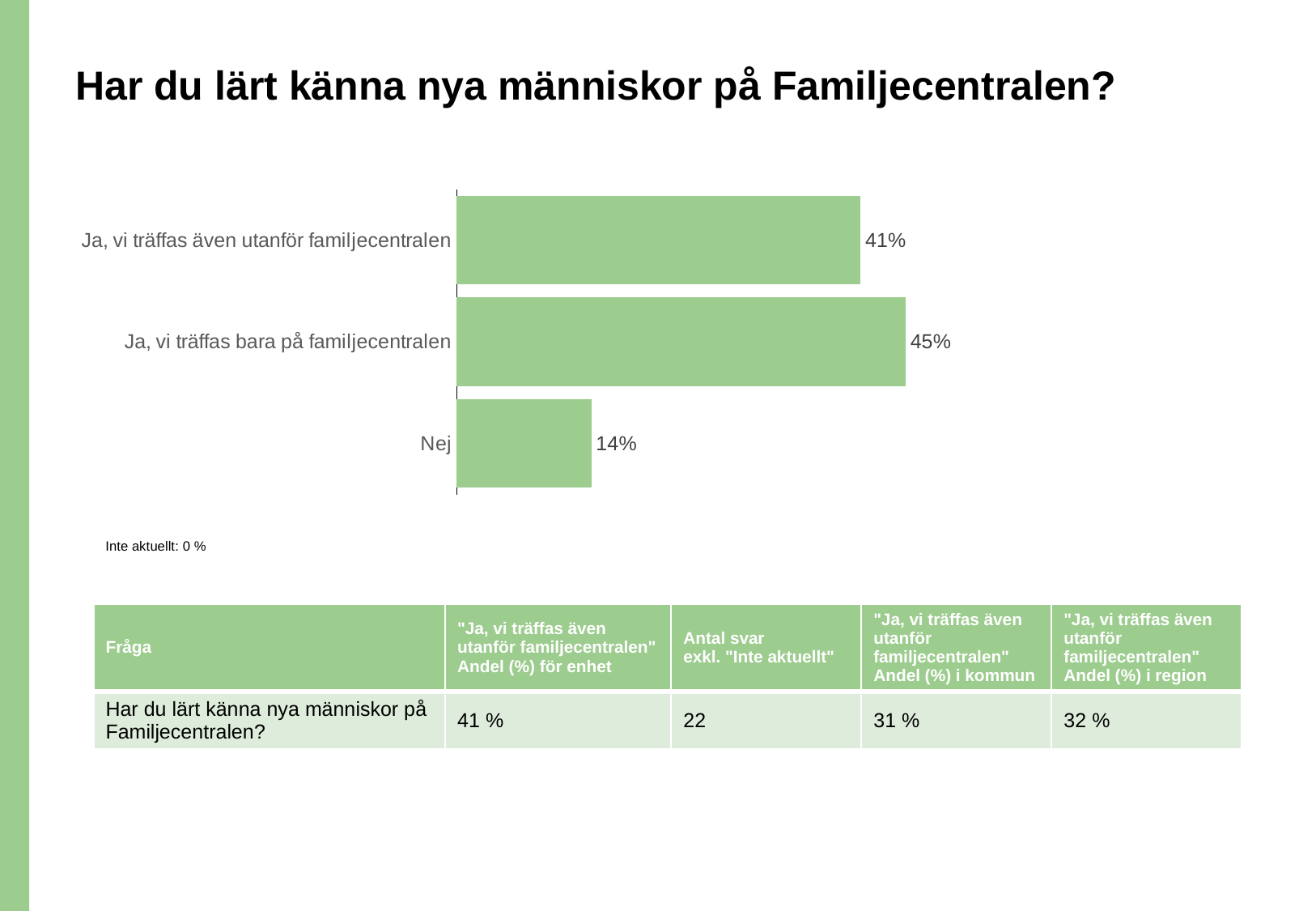
What is the title of the slide? Har du lärt känna nya människor på Familjecentralen? Which category has the lowest value? Nej What is the difference between "Ja, vi träffas bara på familjecentralen" and "Ja, vi träffas även utanför familjecentralen"? 4% How many categories are shown in the chart? 3 What colour are the bars in the chart? Green Which is larger, the value for "Nej" or the value for "Ja, vi träffas även utanför familjecentralen"? Ja, vi träffas även utanför familjecentralen What is the value for "Nej"? 14% What is the difference between "Ja, vi träffas även utanför familjecentralen" and "Nej"? 27% What is the value for "Ja, vi träffas bara på familjecentralen"? 45% Which category has the highest value? Ja, vi träffas bara på familjecentralen What is the value for "Ja, vi träffas även utanför familjecentralen"? 41% What kind of chart is shown on the slide? Bar chart